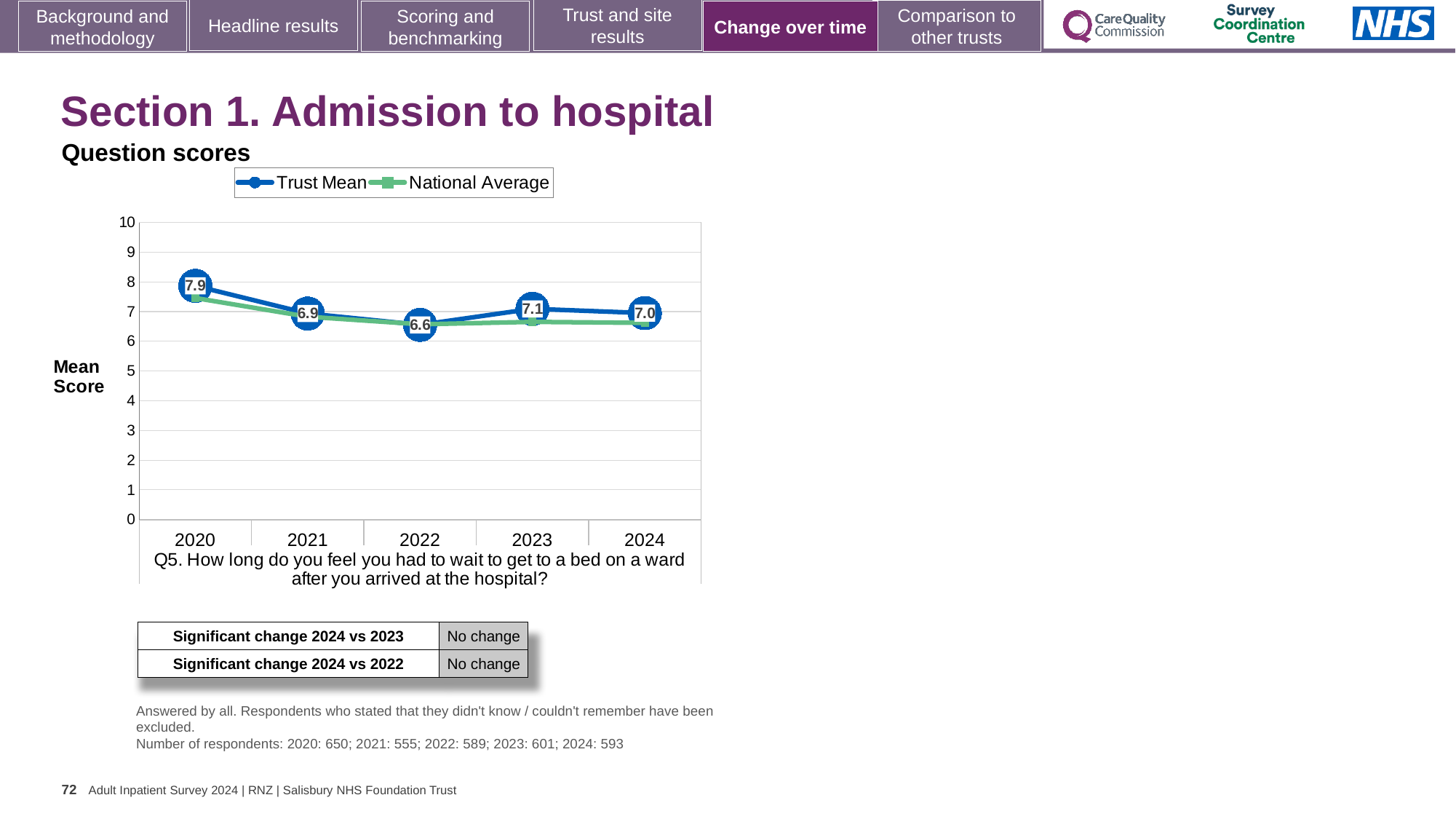
What is the Trust Mean score for 2024? 7.0 How many years are plotted on the x axis of the chart? 5 What is the Trust Mean score for 2022? 6.6 In which year was the Trust Mean score highest? 2020 Is the National Average value for 2020 greater or less than 7? greater In which year was the Trust Mean score lowest? 2022 What is the Trust Mean score for 2020? 7.9 What kind of chart is shown on the slide? Line chart Which year has the larger Trust Mean score, 2020 or 2023? 2020 Does the Trust Mean score rise or fall from 2020 to 2022? Fall How many series does the chart legend list? 2 What is the difference between the Trust Mean scores for 2020 and 2021? 1.0